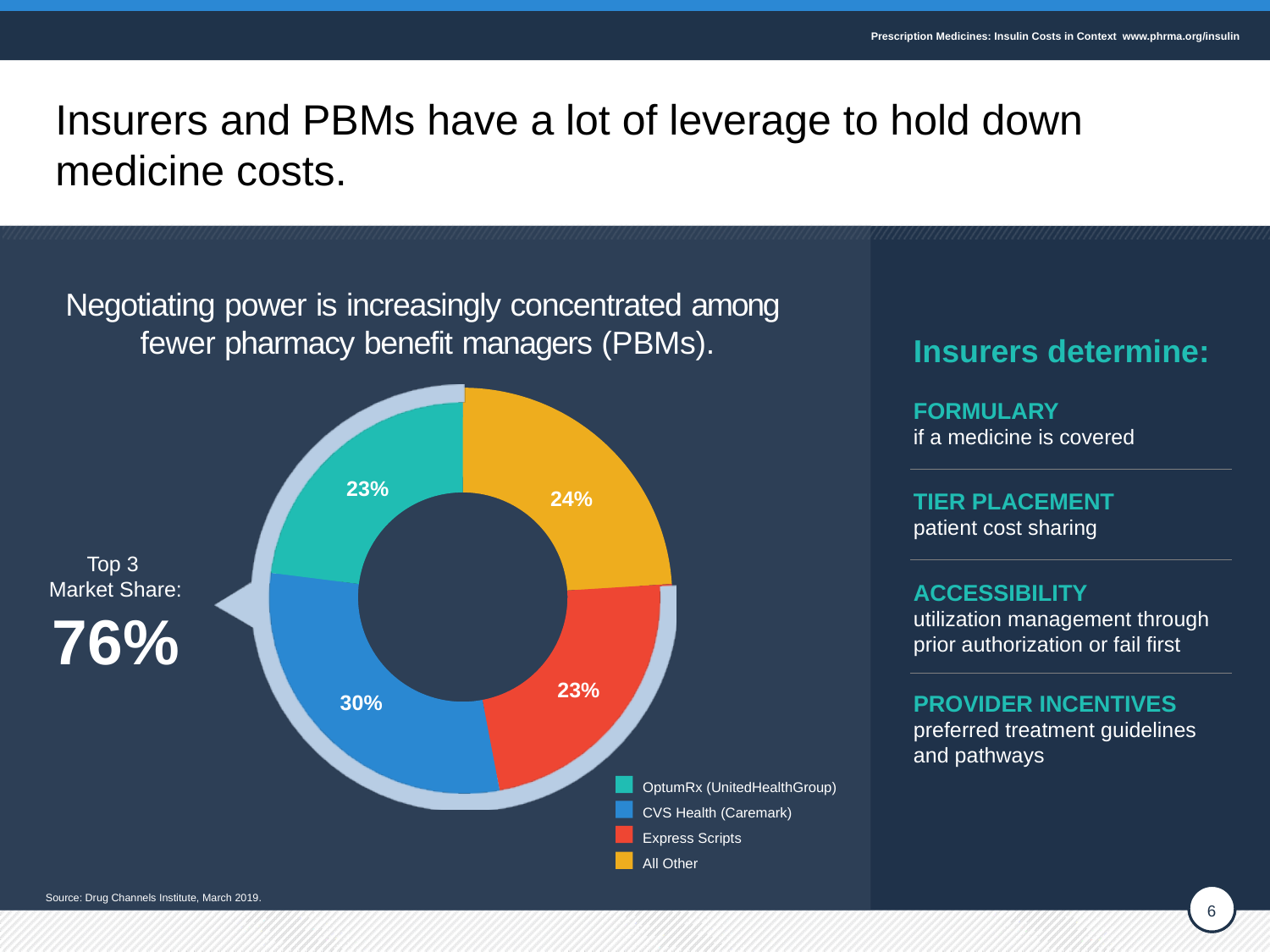
Which is larger, the share for All Other or the share for OptumRx (UnitedHealthGroup)? All Other Which PBM has the largest market share in the chart? CVS Health (Caremark) What is the market share for Express Scripts? 23% How many entries does the legend list? 4 What combined market share do the top 3 PBMs hold, according to the callout next to the chart? 76% What is the difference in market share between CVS Health (Caremark) and Express Scripts? 7 percentage points What is the market share for CVS Health (Caremark)? 30% What share of the pie is labelled All Other? 24% What kind of chart is shown on the slide? Pie chart (donut) Which colour represents Express Scripts in the chart? Red What is the market share for OptumRx (UnitedHealthGroup)? 23% How many slices does the pie chart have? 4